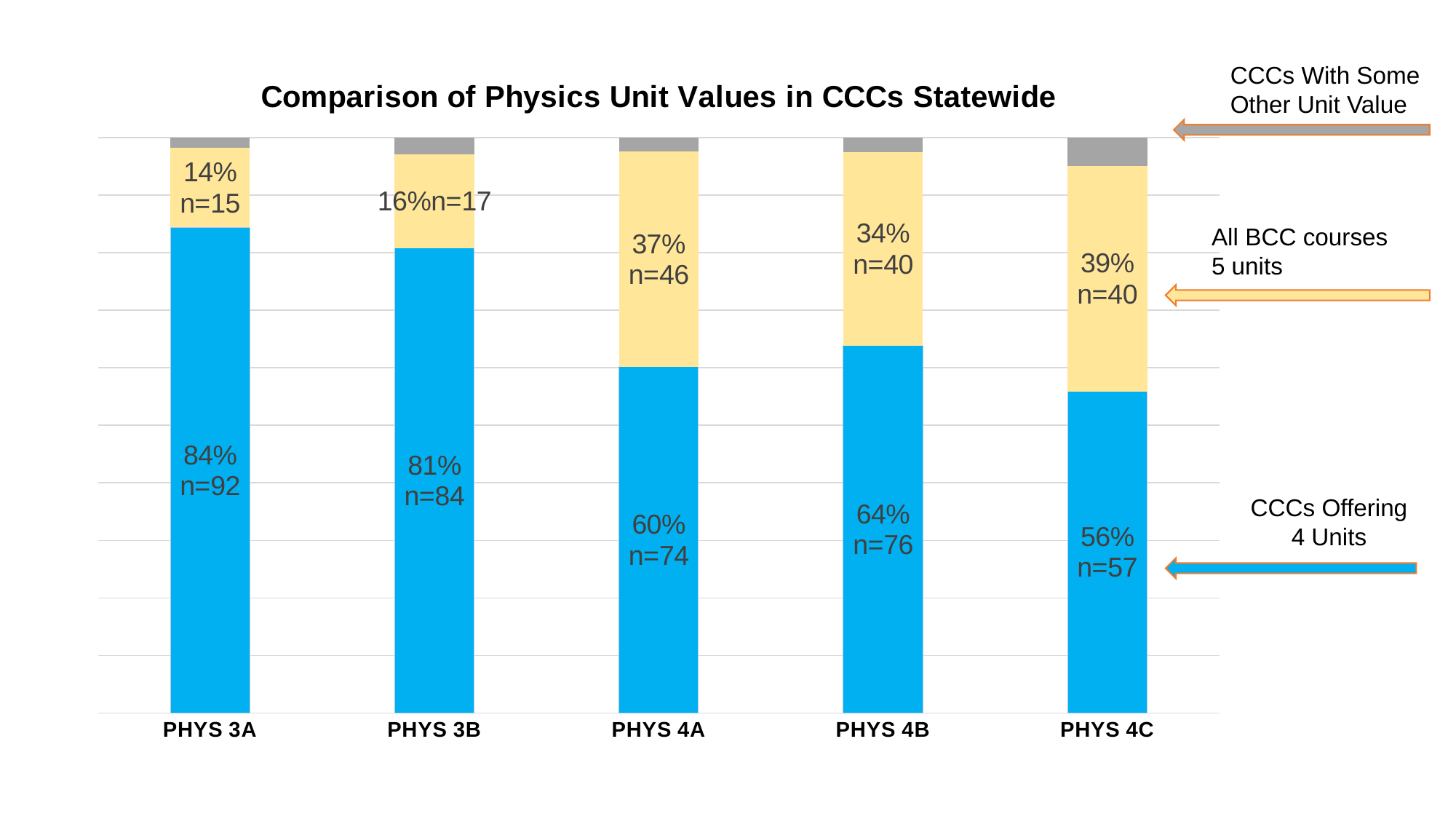
What is the difference in percentage points between the 4-unit share for PHYS 3A and for PHYS 4C? 28 How many physics courses are shown along the x axis? 5 What percentage of CCCs offer PHYS 4C as 5 units? 39% What kind of chart is shown on the slide? Stacked bar chart What is the title of the chart? Comparison of Physics Unit Values in CCCs Statewide What percentage of CCCs offer PHYS 3A as 4 units? 84% Which course has the lowest percentage of CCCs offering it as 5 units? PHYS 3A Which course has the highest percentage of CCCs offering it as 4 units? PHYS 3A Which course has the lowest percentage of CCCs offering it as 4 units? PHYS 4C How many series (segment types) are identified by the labels on the right of the chart? 3 Which has a larger 4-unit percentage, PHYS 4A or PHYS 4B? PHYS 4B What is the n value for CCCs offering PHYS 4A as 4 units? n=74